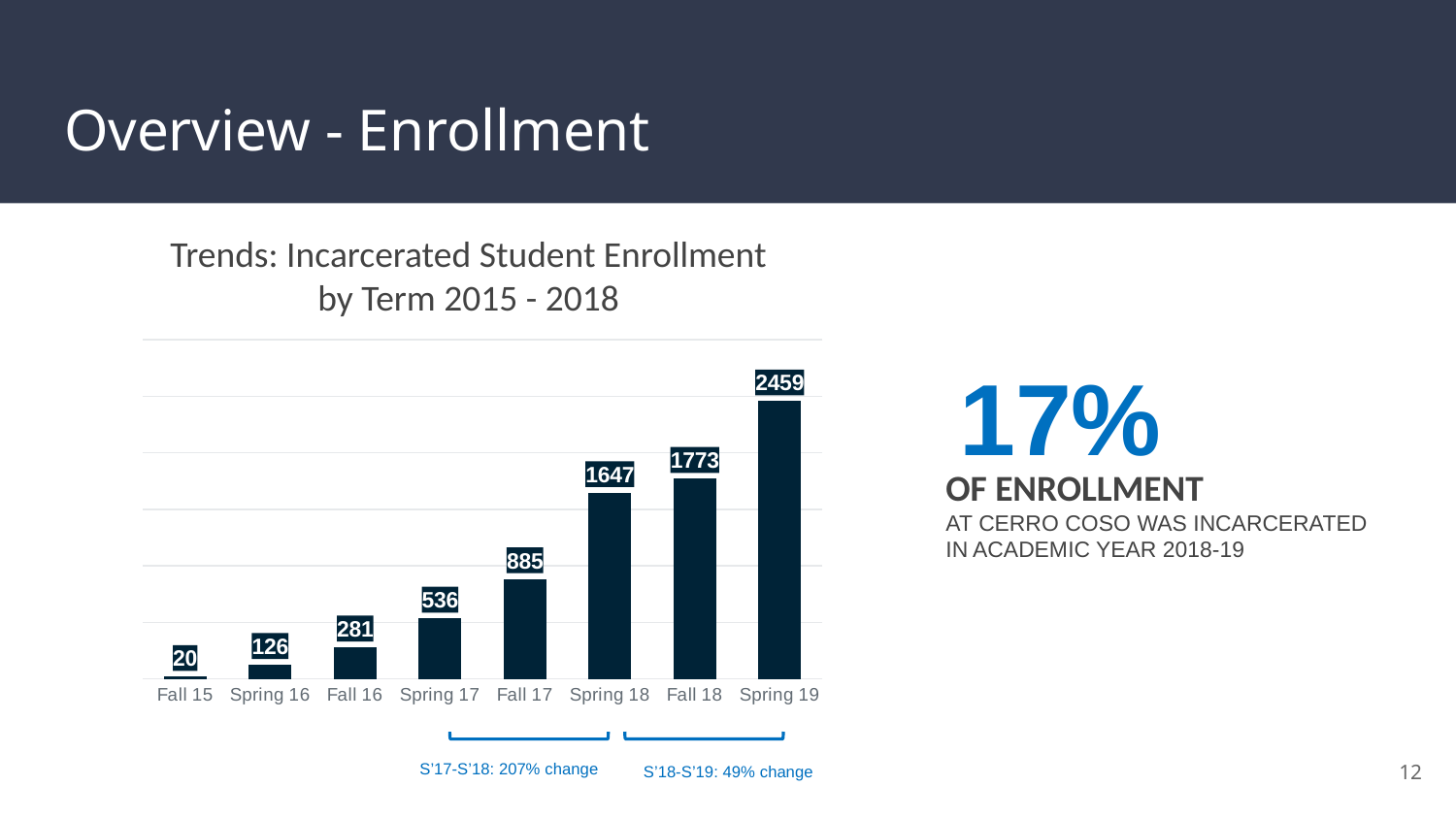
Which term has the lowest enrollment? Fall 15 What is the difference in enrollment between Spring 19 and Fall 18? 686 What is the enrollment value for Fall 17? 885 What is the title of the chart? Trends: Incarcerated Student Enrollment by Term 2015 - 2018 Which term has the highest enrollment? Spring 19 What kind of chart is shown on the slide? Bar chart Do the enrollment values rise or fall from Fall 15 to Spring 19? Rise What is the difference in enrollment between Spring 17 and Fall 16? 255 What is the enrollment value for Fall 15? 20 How many terms are shown on the x axis? 8 Which is larger, the enrollment for Fall 17 or for Spring 17? Fall 17 What is the enrollment value for Spring 18? 1647